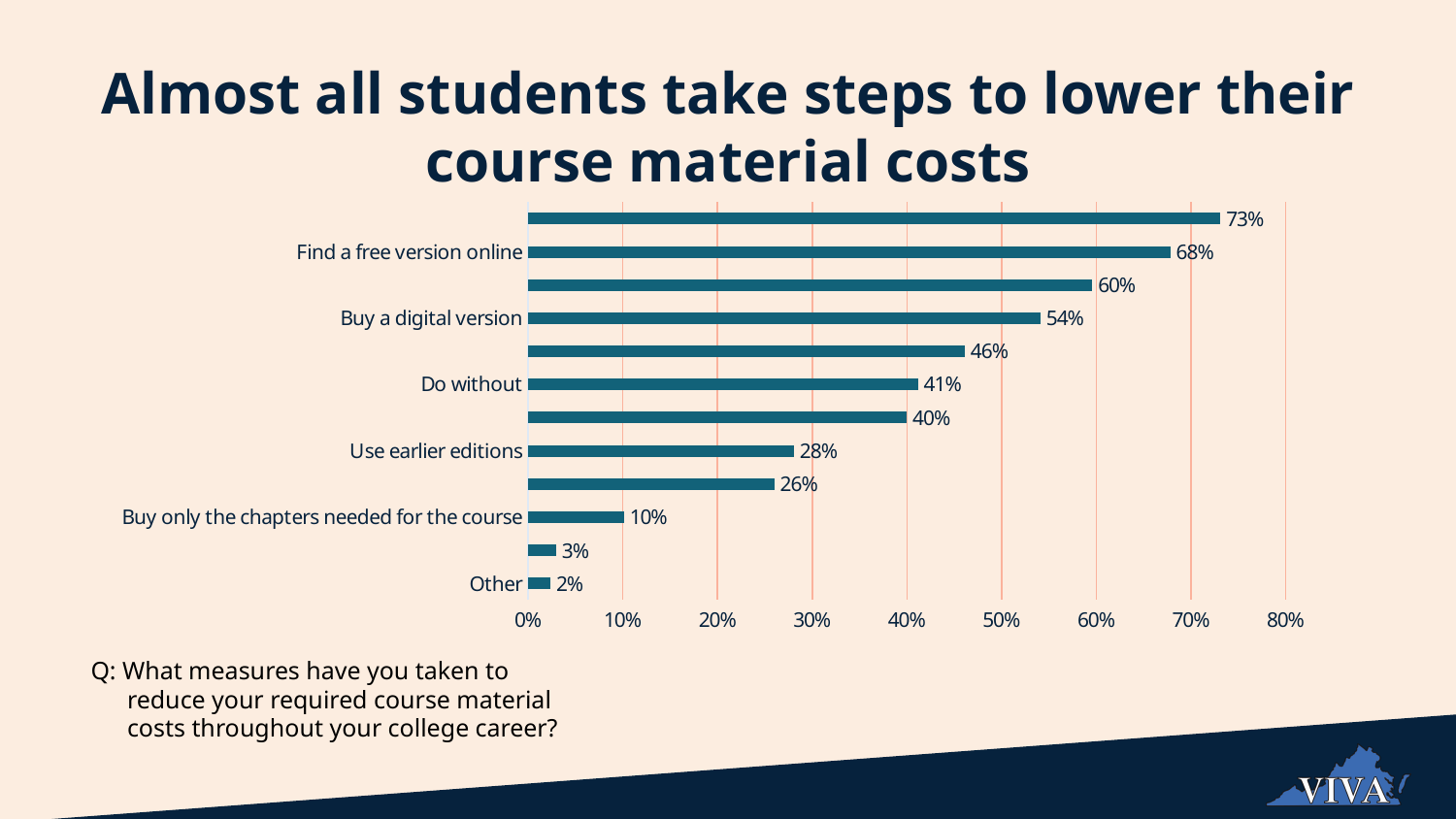
What is the difference between "Find a free version online" and "Buy a digital version"? 14% What is the highest value shown on any bar in the chart? 73% What is the value for "Use earlier editions"? 28% What kind of chart is shown on the slide? Bar chart What percentage of students find a free version online? 68% What is the value for "Buy a digital version"? 54% Which labelled category has the lowest value? Other How many bars are plotted in the chart? 12 What is the highest value shown on the x axis? 80% What percentage of students say they do without? 41% Which is larger, the value for "Do without" or the value for "Use earlier editions"? Do without What percentage of students buy only the chapters needed for the course? 10%